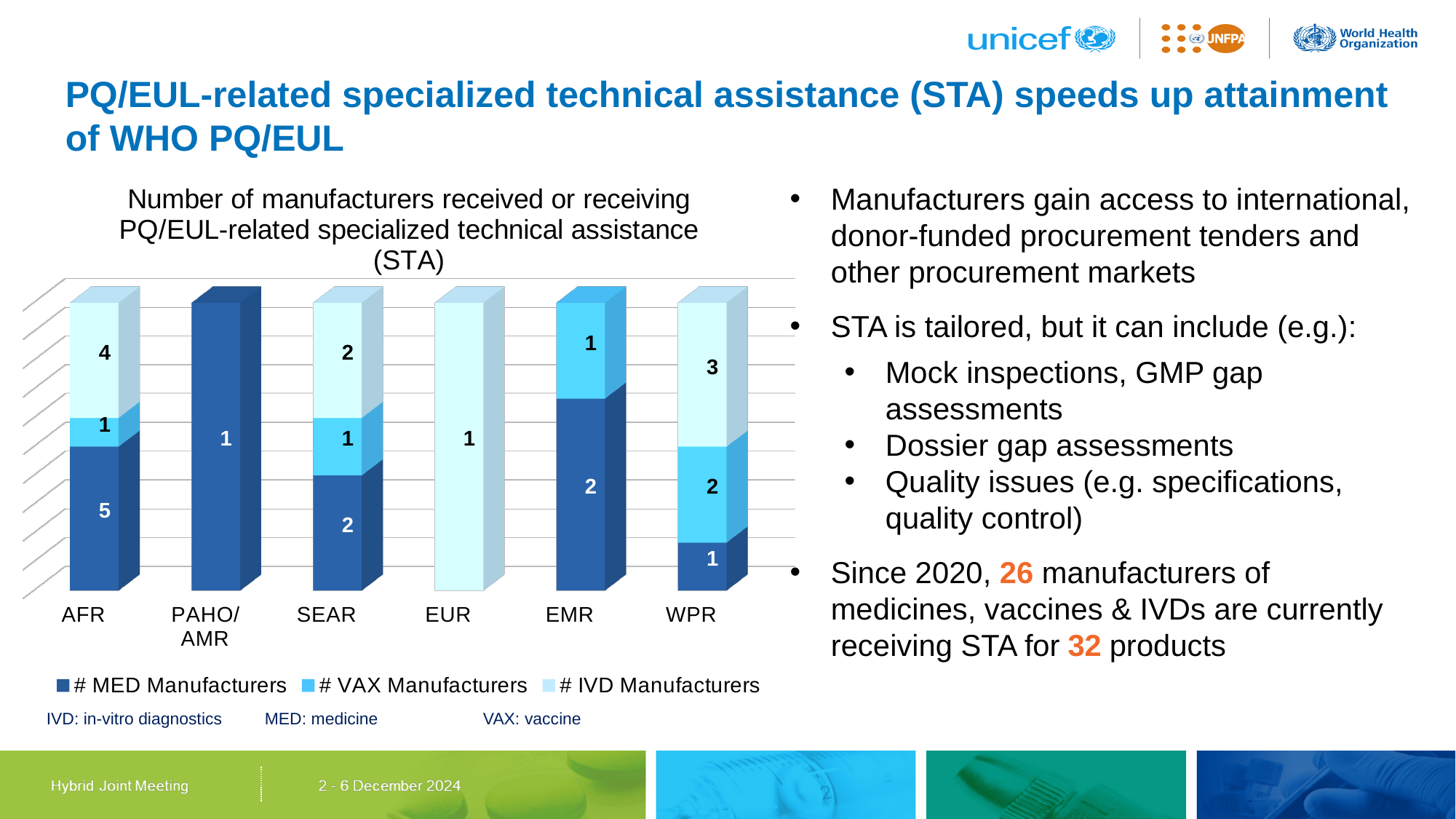
Which has more IVD manufacturers, AFR or SEAR? AFR How many VAX manufacturers are shown for EMR? 1 What kind of chart is shown on the slide? Stacked bar chart What is the difference between the number of MED manufacturers in AFR and in SEAR? 3 Which series is shown in the darkest blue colour in the chart? # MED Manufacturers How many series does the chart legend list? 3 What is the total number of manufacturers across all three series for AFR? 10 How many IVD manufacturers are shown for EUR? 1 What is the total number of manufacturers across all three series for WPR? 6 How many regions are shown on the x axis of the chart? 6 How many IVD manufacturers are shown for WPR? 3 How many MED manufacturers are shown for AFR? 5